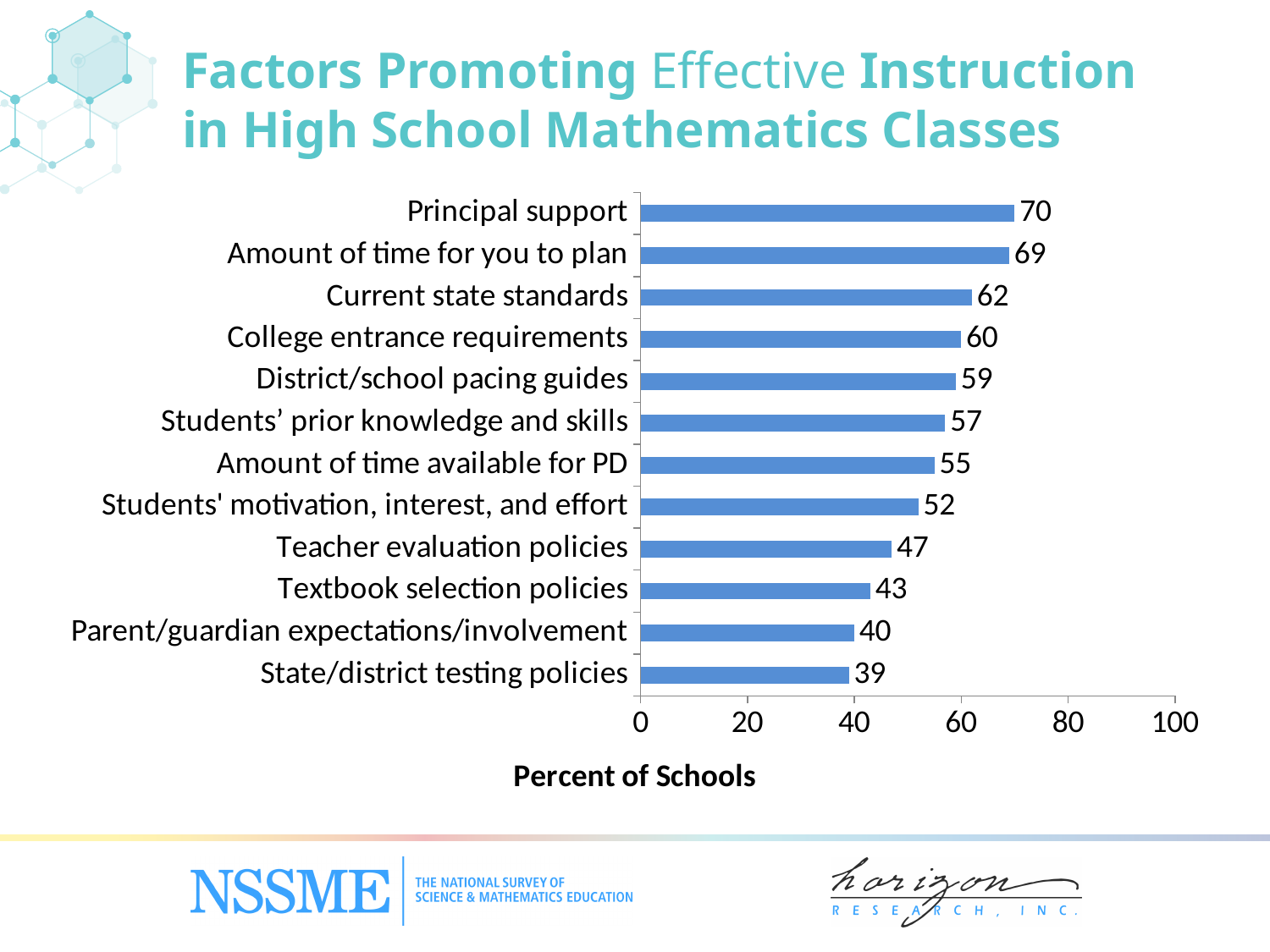
What is the value for Students' motivation, interest, and effort? 52 What is the difference between the values for Principal support and State/district testing policies? 31 What is the value for Principal support? 70 Which factor has the highest value? Principal support Which is larger, the value for District/school pacing guides or the value for Amount of time available for PD? District/school pacing guides Is the value for Parent/guardian expectations/involvement greater or less than 60? less Which factor has the lowest value? State/district testing policies How many factors are shown in the chart? 12 What is the label of the horizontal axis? Percent of Schools What is the difference between the values for Current state standards and Textbook selection policies? 19 What kind of chart is shown on the slide? bar chart What is the value for Teacher evaluation policies? 47